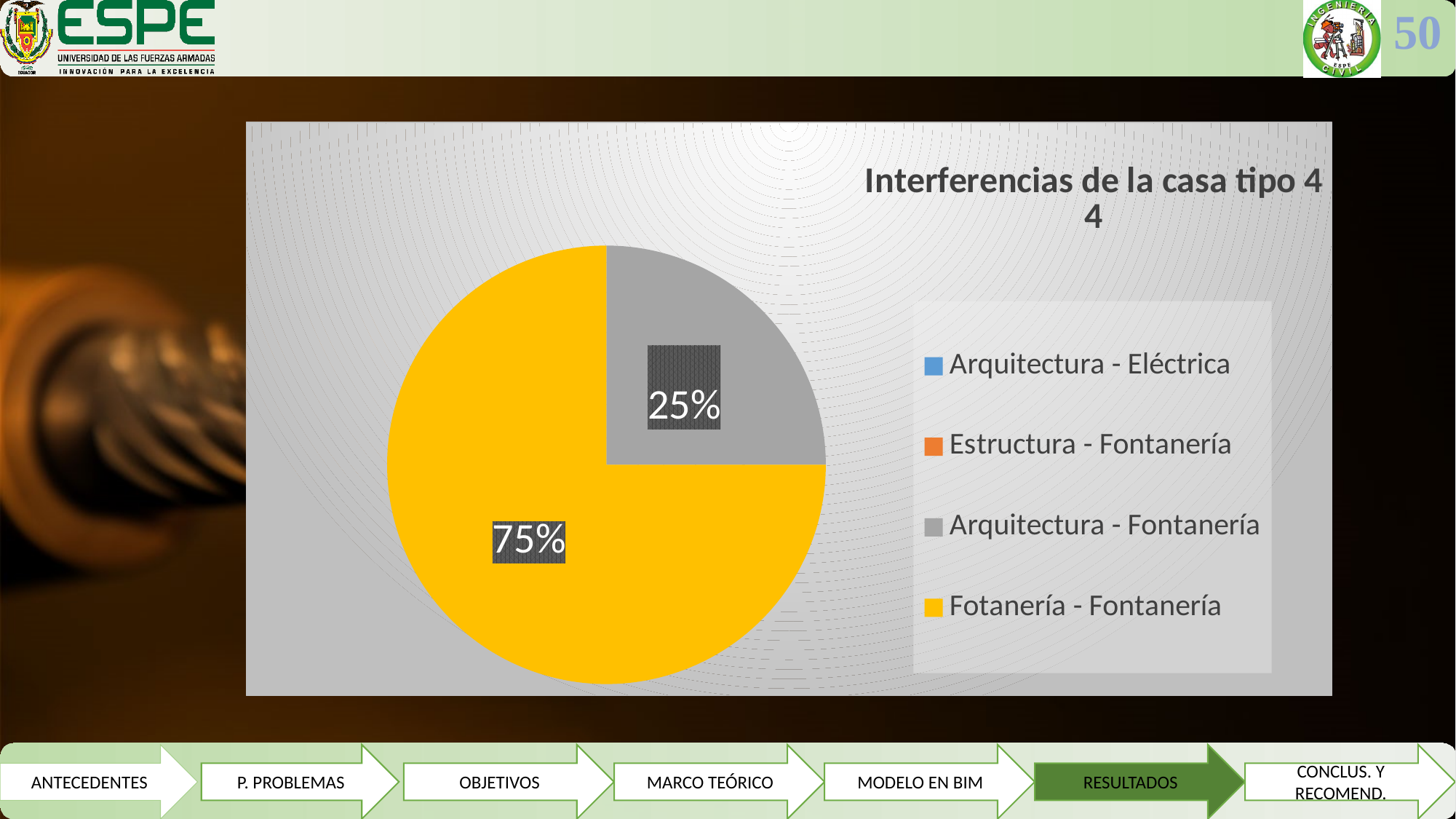
Which is larger, the Arquitectura - Fontanería slice or the Fotanería - Fontanería slice? Fotanería - Fontanería What is the difference in percentage points between the Fotanería - Fontanería slice and the Arquitectura - Fontanería slice? 50% What percentage of the pie does Fotanería - Fontanería represent? 75% What colour is the Fotanería - Fontanería slice? yellow What is the title of the chart? Interferencias de la casa tipo 4 4 Which category has the largest slice of the pie? Fotanería - Fontanería What percentage of the pie does Arquitectura - Fontanería represent? 25% What is the combined percentage of the two labelled slices? 100% How many slices with data labels are visible in the pie? 2 How many entries does the legend list? 4 What type of chart is shown on the slide? pie chart